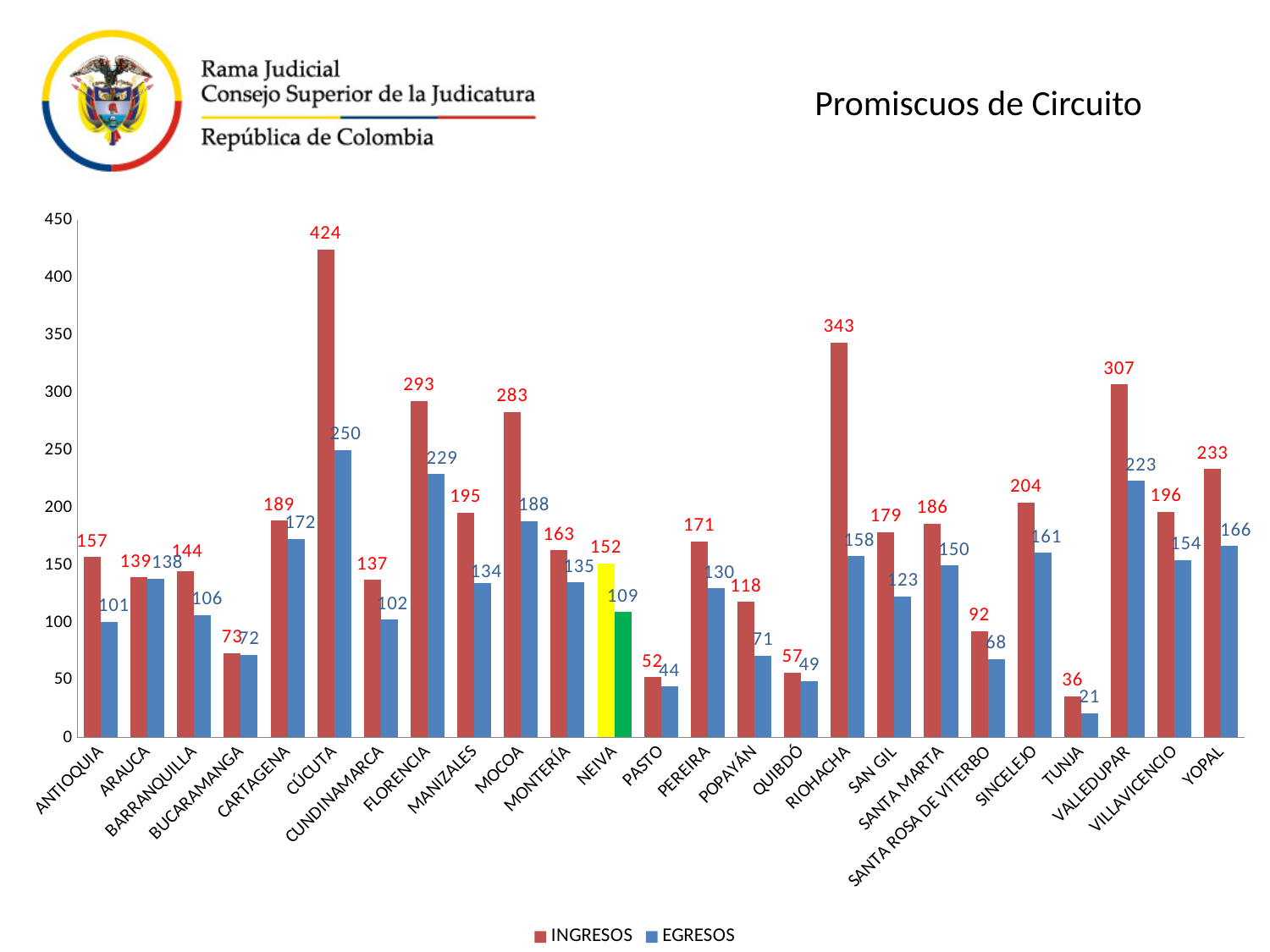
How many categories are shown on the x axis? 25 What is the difference between INGRESOS and EGRESOS for RIOHACHA? 185 What is the INGRESOS value for CÚCUTA? 424 What is the EGRESOS value for NEIVA? 109 How many series does the legend list? 2 What is the EGRESOS value for RIOHACHA? 158 Which category has the highest INGRESOS value? CÚCUTA What kind of chart is shown on the slide? Bar chart What is the title of the chart? Promiscuos de Circuito Which is larger, the INGRESOS value for VALLEDUPAR or the INGRESOS value for FLORENCIA? VALLEDUPAR Which category has the lowest EGRESOS value? TUNJA What is the INGRESOS value for TUNJA? 36